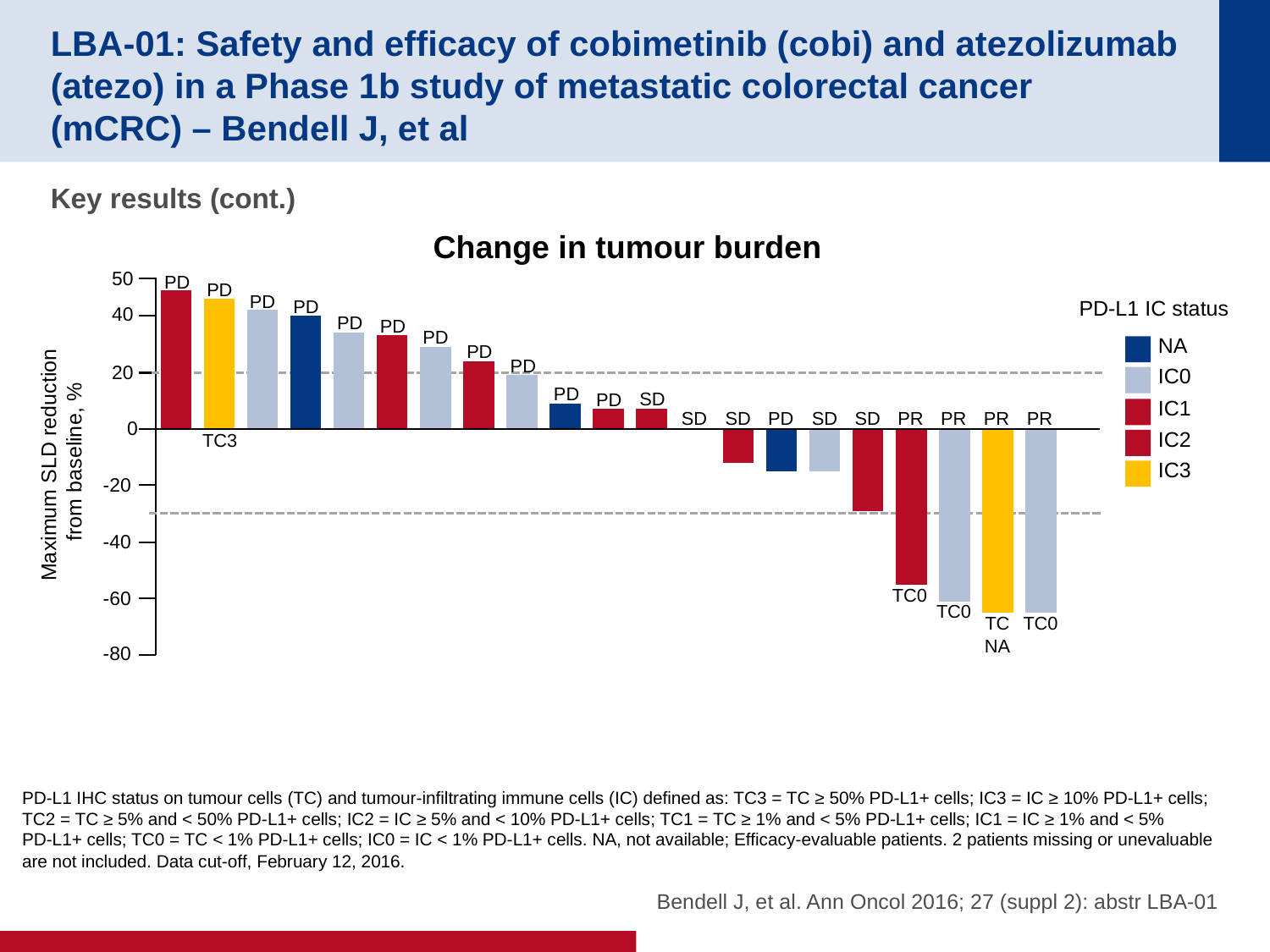
How many bars are labelled PD in the chart? 12 How many entries does the chart legend list? 5 Is the value of the bar labelled TC3 greater or less than 40? greater How many patients (bars) are shown in the chart in total? 21 Is the value of the leftmost bar (labelled PD) greater or less than 40? greater What is the title of the legend? PD-L1 IC status How many bars are labelled PR in the chart? 4 Do the bar values rise or fall moving from left to right along the x axis? Fall Which response label is attached to the tallest positive bar? PD What is the title of the chart? Change in tumour burden What type of chart is shown on the slide? Bar chart Is the value of the rightmost bar (PR, TC0) greater or less than -40? less